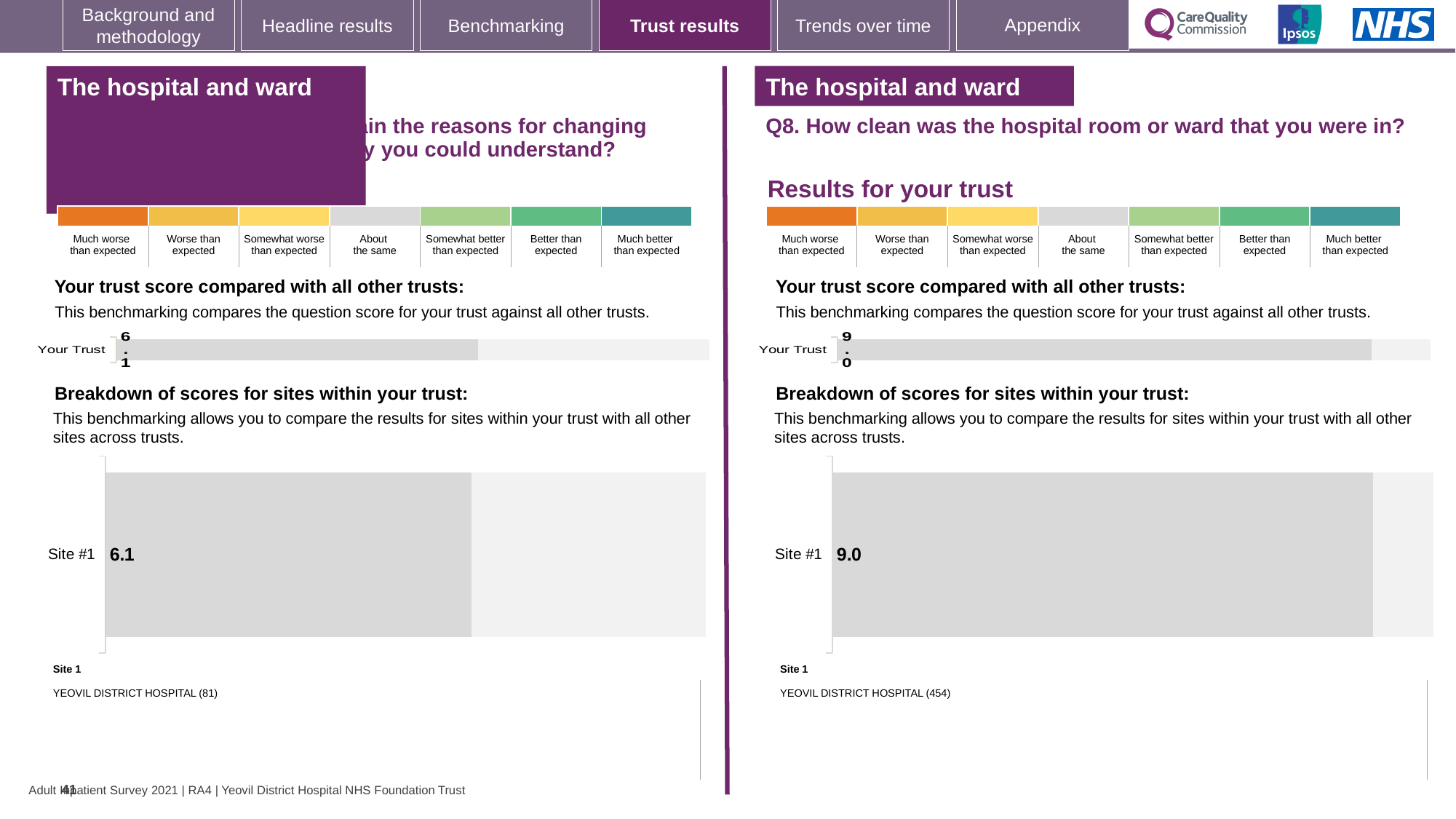
How many sites are shown in the breakdown of scores chart on the right-hand side of the slide (Q8)? 1 What kind of chart is used to show the Site #1 score on the right-hand side of the slide (Q8)? Bar chart On the right-hand side of the slide (Q8, how clean was the hospital room or ward), what is the score shown for Your Trust? 9.0 On the right-hand side of the slide (Q8), what is the score shown for Site #1? 9.0 On the left-hand side of the slide, which site name is listed as Site 1 below the breakdown chart? YEOVIL DISTRICT HOSPITAL (81) On the right-hand side of the slide, which site name is listed as Site 1 below the breakdown chart? YEOVIL DISTRICT HOSPITAL (454) On the left-hand side of the slide, what is the score shown for Your Trust? 6.1 Which is larger: the Site #1 score on the left-hand side of the slide or the Site #1 score on the right-hand side (Q8)? Right-hand side (Q8), 9.0 What is the difference between the Site #1 score for Q8 on the right-hand side and the Site #1 score on the left-hand side of the slide? 2.9 Is the Your Trust score for Q8 on the right-hand side of the slide the same as the Site #1 score for Q8? Yes, both are 9.0 On the left-hand side of the slide, what is the score shown for Site #1 in the breakdown of scores for sites within your trust? 6.1 How many sites are shown in the breakdown of scores chart on the left-hand side of the slide? 1